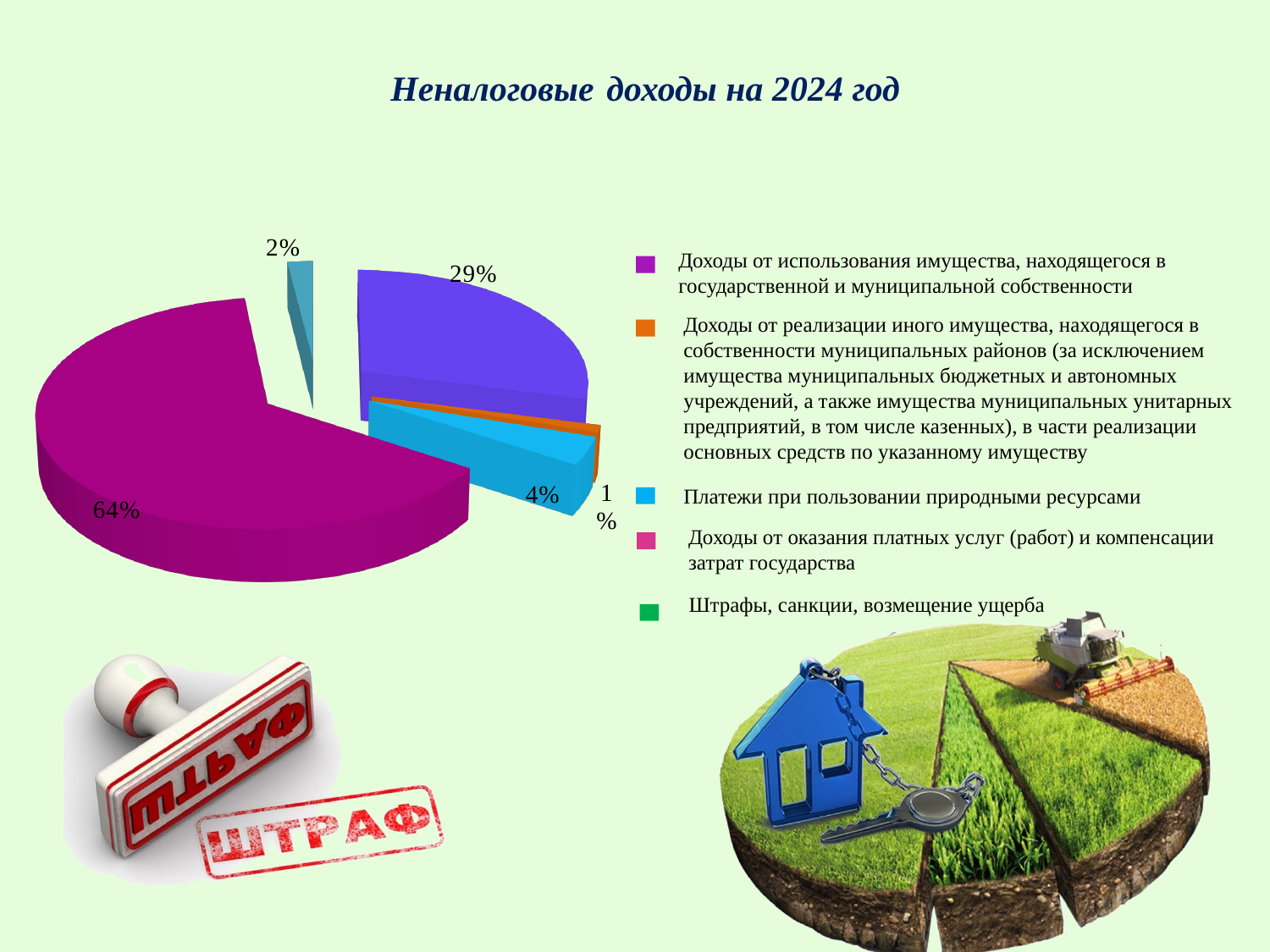
What is the largest share shown in the pie chart? 64% What is the smallest share shown in the pie chart? 1% What kind of chart is shown on the slide? pie chart What is the title of the chart on the slide? Неналоговые доходы на 2024 год What share of the pie is labelled for the purple slice (Доходы от использования имущества, находящегося в государственной и муниципальной собственности)? 29% What share of the pie is labelled for the blue slice (Платежи при пользовании природными ресурсами)? 4% What share of the pie is labelled for the orange slice (Доходы от реализации иного имущества)? 1% Which is larger, the 4% slice or the 2% slice? the 4% slice What is the difference between the largest slice (64%) and the 29% slice? 35% Which legend entry is shown with a green marker? Штрафы, санкции, возмещение ущерба How many entries does the chart legend list? 5 How many slices does the pie chart have? 5